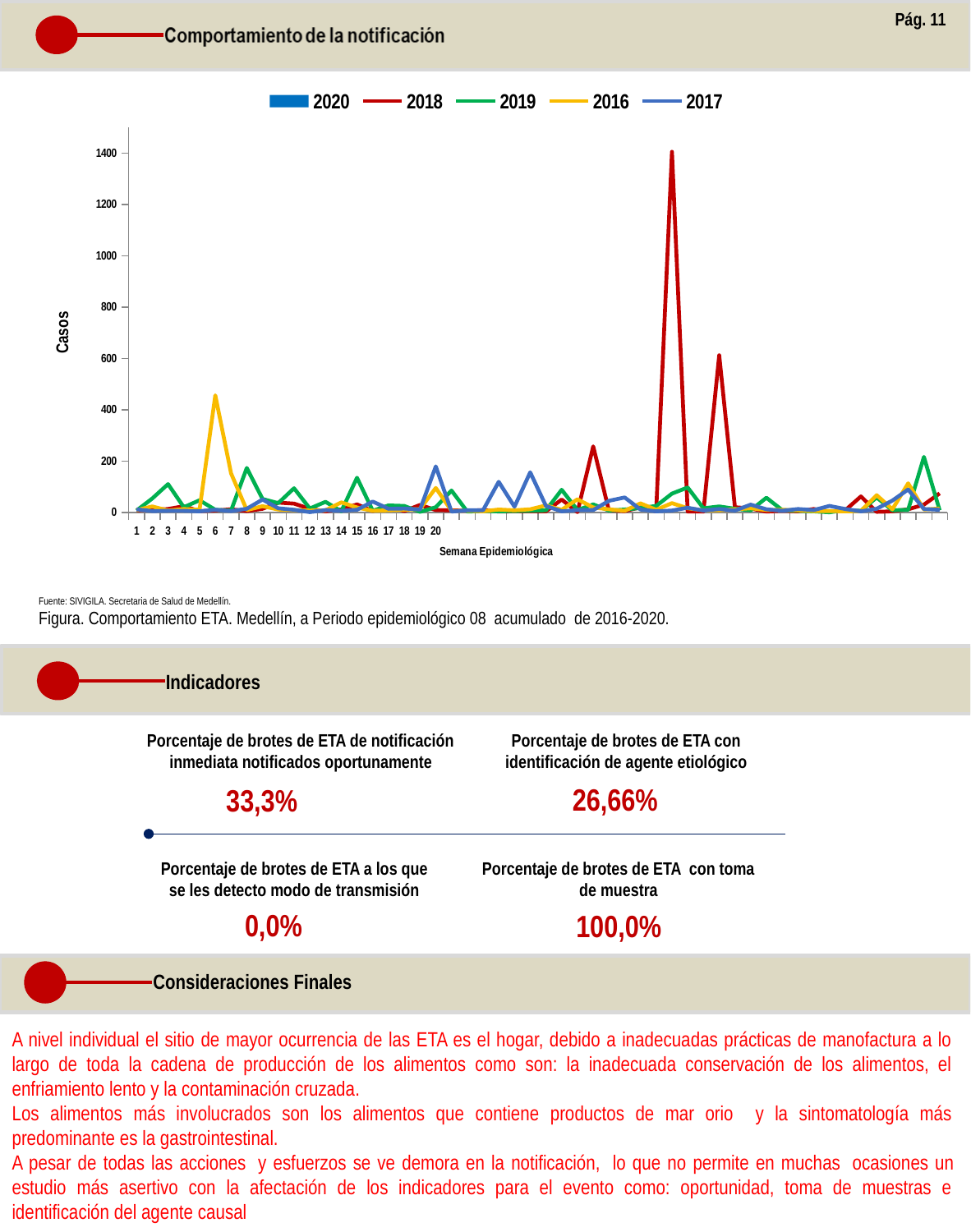
Which series reaches the highest value on the chart? 2018 Is the peak of the 2016 series at week 6 greater or less than 400 cases? greater What is the title of the x axis of the chart? Semana Epidemiológica Is the highest peak of the 2018 series greater or less than 1200 cases? greater What is the highest value labeled on the y axis of the chart? 1400 Is the peak of the 2019 series at week 8 greater or less than 400 cases? less What kind of chart is shown on the slide? combination bar and line chart Which series has the larger maximum value, 2018 or 2016? 2018 How many series does the chart legend list? 5 Which series has the larger maximum value, 2016 or 2017? 2016